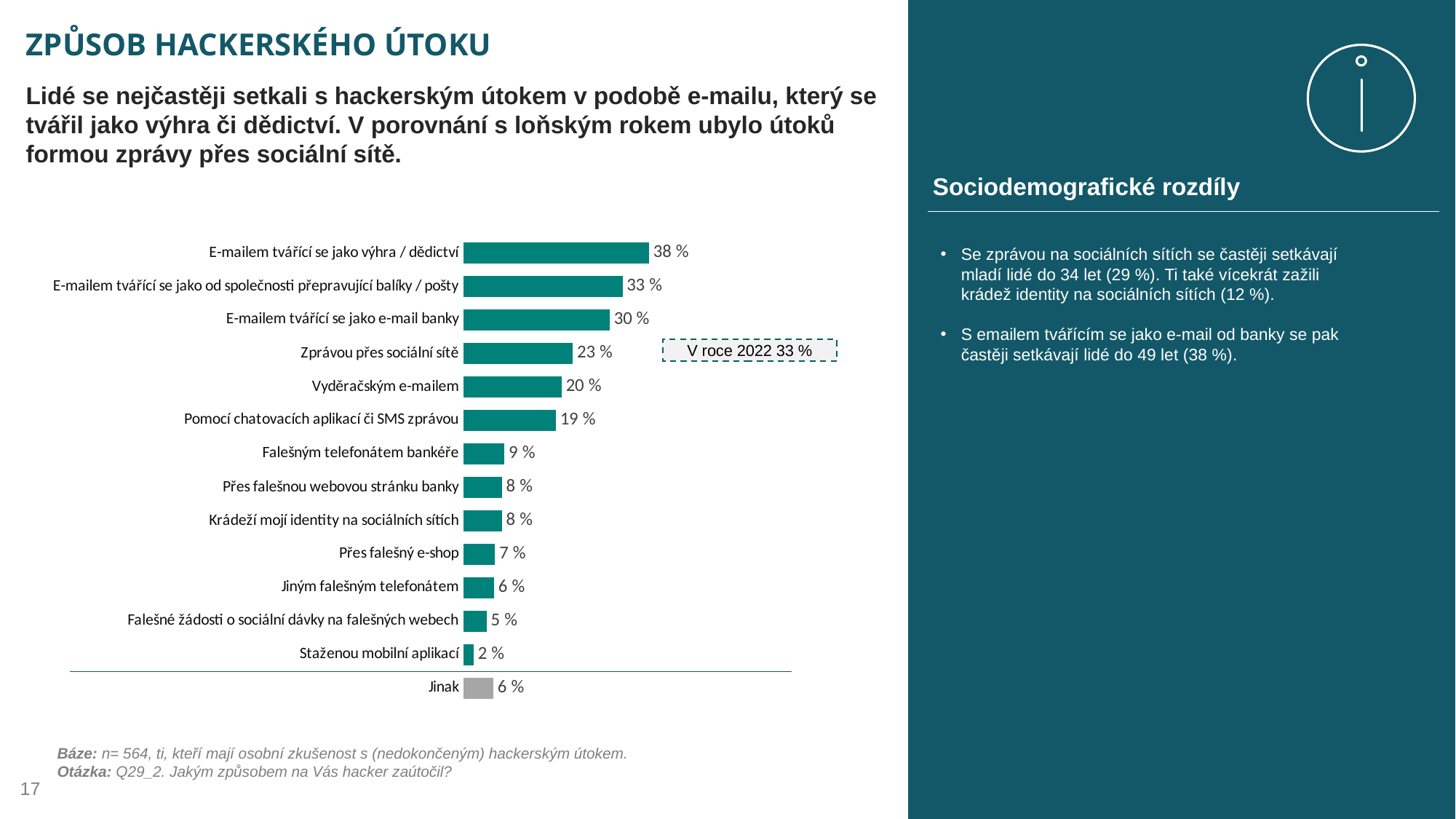
Which category's bar is drawn in grey rather than teal? Jinak Which is larger: the value for "Vyděračským e-mailem" or the value for "Pomocí chatovacích aplikací či SMS zprávou"? Vyděračským e-mailem What kind of chart is shown on the slide? Bar chart What value is shown for "Zprávou přes sociální sítě"? 23 % How many categories are plotted in the chart? 14 According to the annotation box, what was the value for "Zprávou přes sociální sítě" in 2022? 33 % What value is shown for "Staženou mobilní aplikací"? 2 % What value is shown for "Jinak"? 6 % Which category has the highest value? E-mailem tvářící se jako výhra / dědictví What is the difference between the values for "E-mailem tvářící se jako výhra / dědictví" and "E-mailem tvářící se jako e-mail banky"? 8 % What value is shown for "E-mailem tvářící se jako výhra / dědictví"? 38 % Which category has the lowest value? Staženou mobilní aplikací